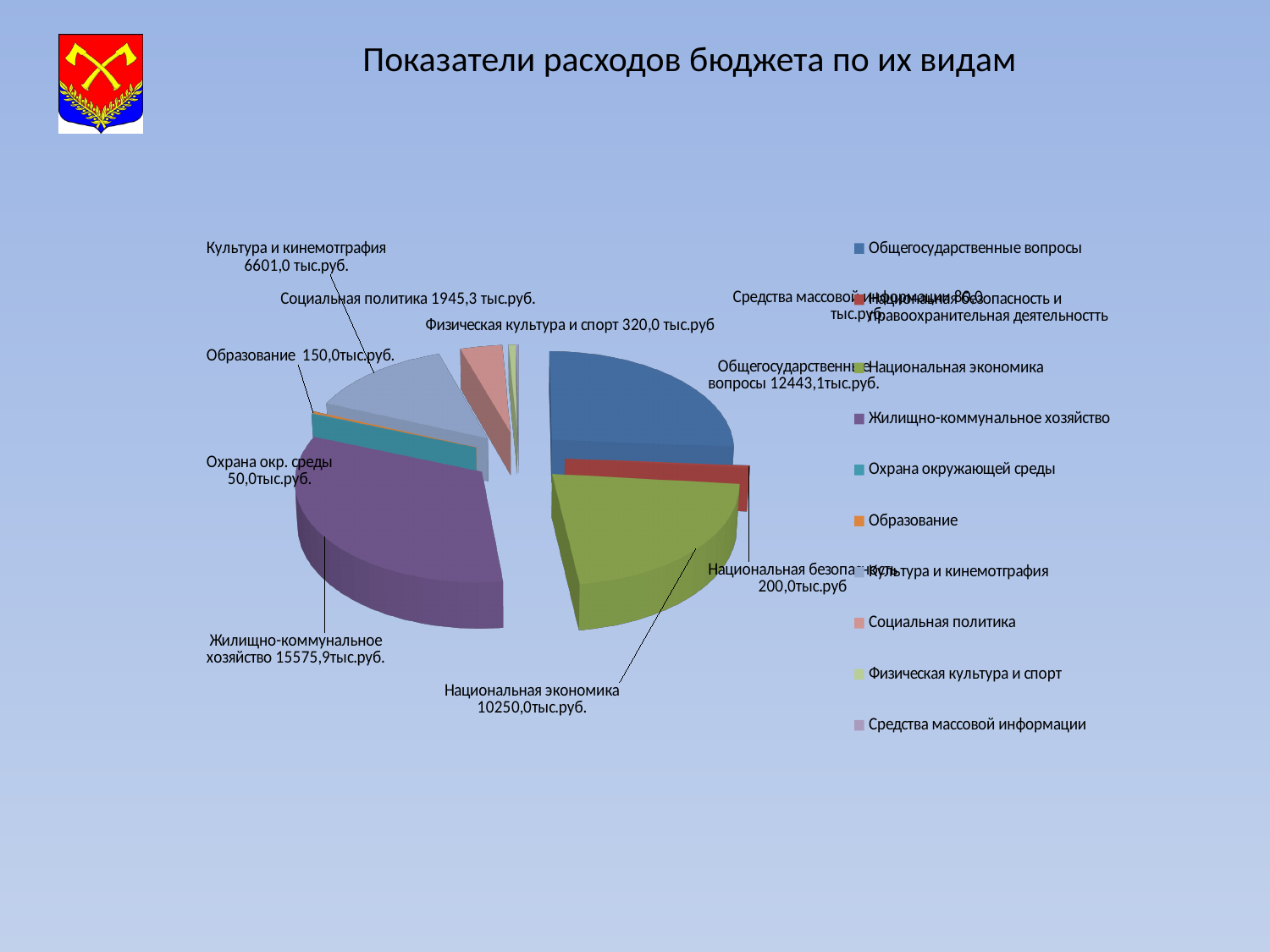
What is the value for Национальная экономика? 10250,0 тыс.руб. Which is larger: Культура и кинемотграфия or Социальная политика? Культура и кинемотграфия What is the title of the slide's chart? Показатели расходов бюджета по их видам Which category has the largest value? Жилищно-коммунальное хозяйство What is the difference between Жилищно-коммунальное хозяйство and Общегосударственные вопросы? 3132,8 тыс.руб. Which category has the smallest value? Охрана окр. среды What is the value for Социальная политика? 1945,3 тыс.руб. What is the value for Общегосударственные вопросы? 12443,1 тыс.руб. How many categories does the legend list? 10 What is the value for Охрана окр. среды? 50,0 тыс.руб. What is the value for Жилищно-коммунальное хозяйство? 15575,9 тыс.руб. What kind of chart is shown on the slide? Pie chart